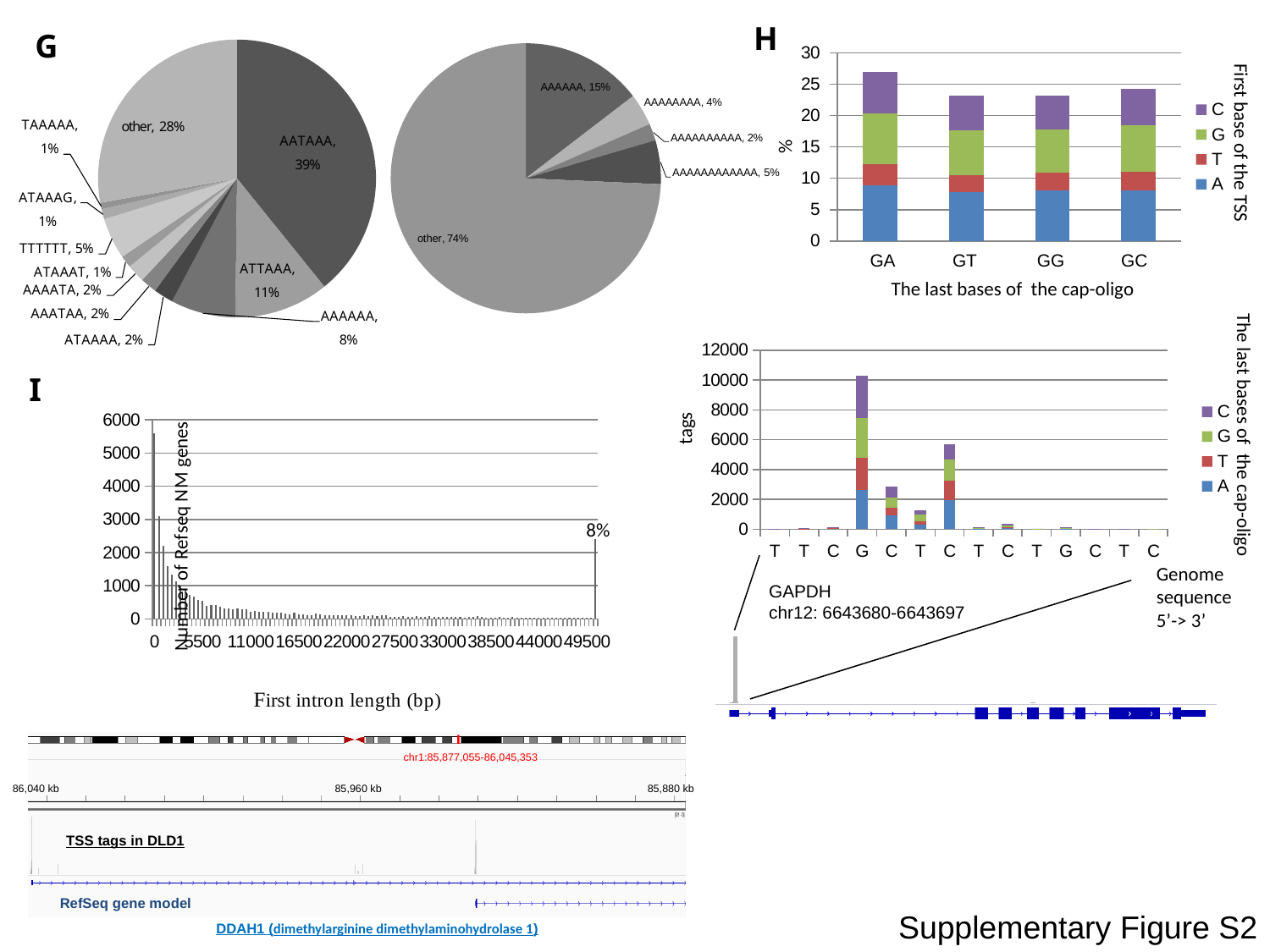
In the stacked bar chart of panel H, is the total for GA greater or less than 25? greater In the GAPDH tags chart on the right, is the tallest bar greater or less than 8000 tags? greater In the stacked bar chart of panel H, how many series does the legend list? 4 In the right pie chart of panel G, what percentage is labelled for AAAAAA? 15% In the right pie chart of panel G, what percentage is labelled 'other'? 74% In the left pie chart of panel G, what is the difference in percentage points between the AATAAA slice and the 'other' slice? 11 In the left pie chart of panel G, which labelled slice other than 'other' has the largest share? AATAAA In the left pie chart of panel G, what percentage is labelled for AATAAA? 39% In the stacked bar chart of panel H, which category has the tallest stacked bar? GA In the right pie chart of panel G, which is larger: the AAAAAAAA slice or the AAAAAAAAAAAA slice? AAAAAAAAAAAA What is the x-axis title of the chart in panel I? First intron length (bp) In the left pie chart of panel G, what percentage is labelled for ATTAAA? 11%